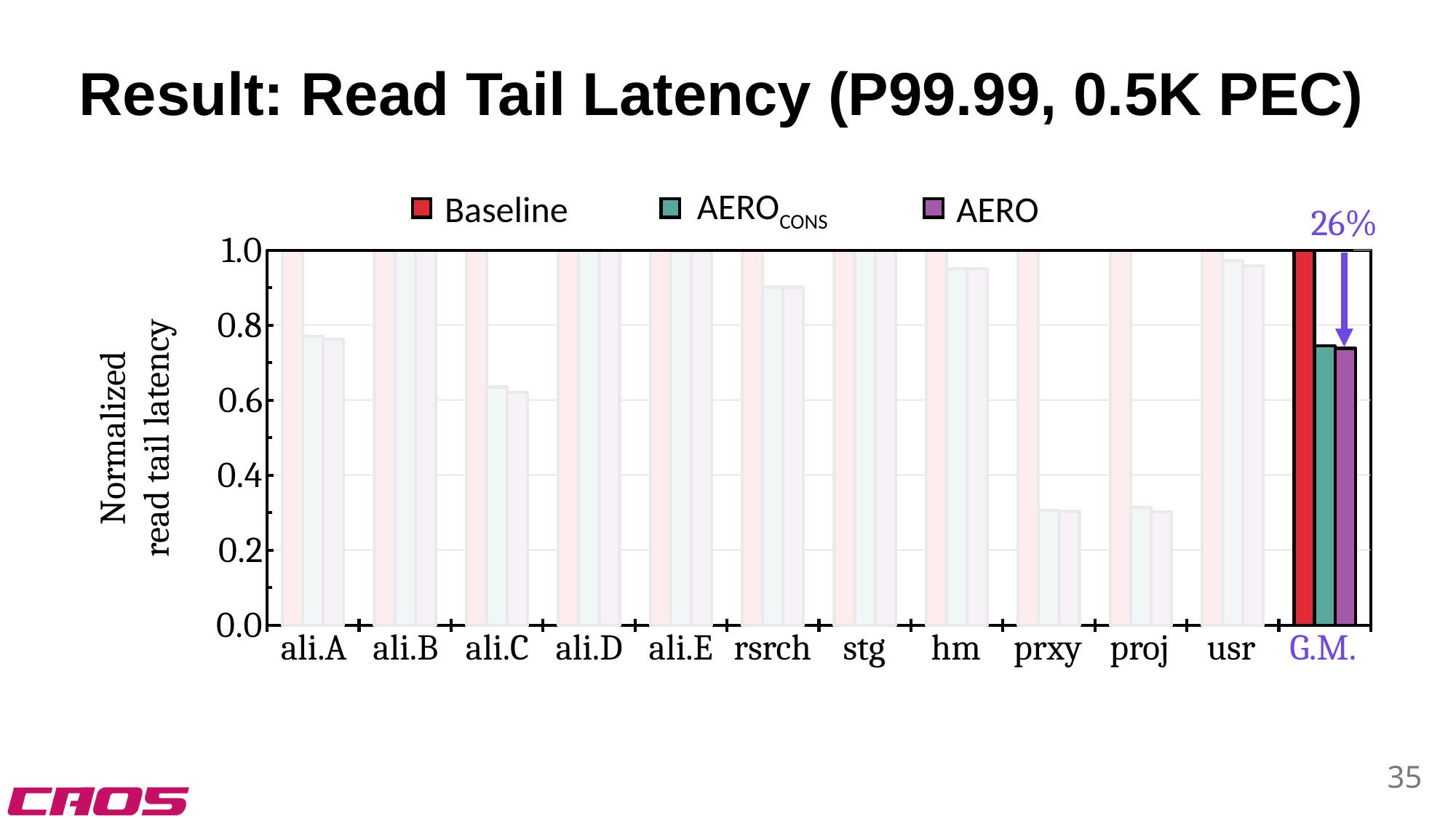
Which is larger for G.M., the Baseline value or the AERO value? Baseline How many series does the legend list? 3 What kind of chart is shown on the slide? bar chart How many categories are shown along the x axis? 12 What is the label of the y axis? Normalized read tail latency Is the AERO value for prxy greater or less than 0.4? less Which is larger, the AERO value for ali.A or the AERO value for ali.C? ali.A Is the AERO value for hm greater or less than 0.8? greater What percentage is annotated above the G.M. bars? 26% What is the Baseline value for G.M.? 1.0 Is the AERO value for G.M. greater or less than 0.8? less